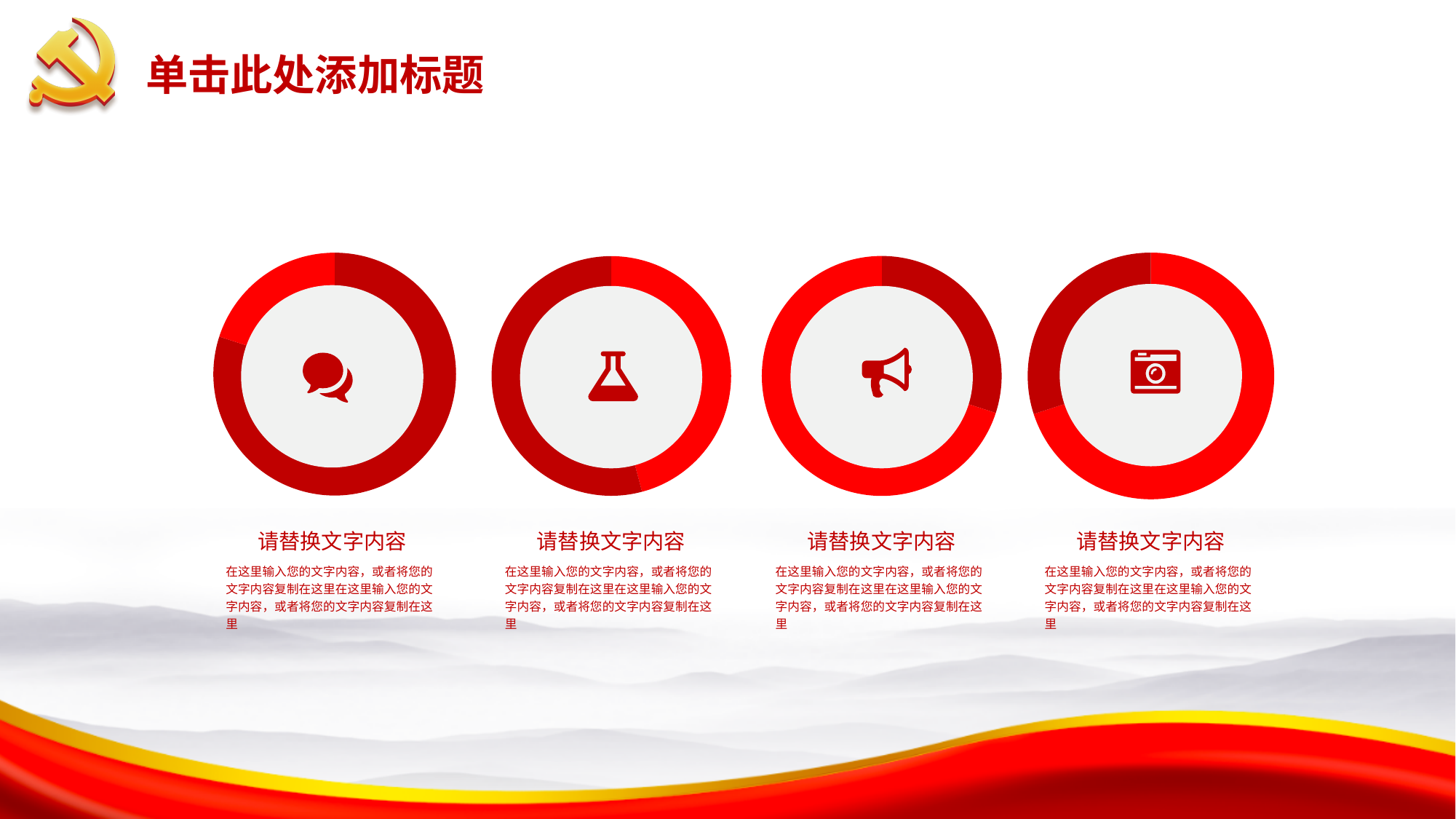
What kind of chart is shown in each of the four circular graphics on the slide? doughnut chart Is the dark-red segment in the first doughnut chart from the left greater or less than half of the ring? less What two colours are used for the segments of the doughnut charts on the slide? bright red and dark red Is the dark-red segment larger in the third doughnut chart from the left or in the first doughnut chart from the left? the third Is the dark-red segment in the third doughnut chart from the left greater or less than half of the ring? greater Which of the four doughnut charts, counting from the left, has the largest dark-red segment? the third Do the doughnut charts on the slide display any data labels or a legend? No How many doughnut charts are shown on the slide? 4 Which of the four doughnut charts, counting from the left, has the smallest dark-red segment? the first How many segments does each doughnut chart on the slide have? 2